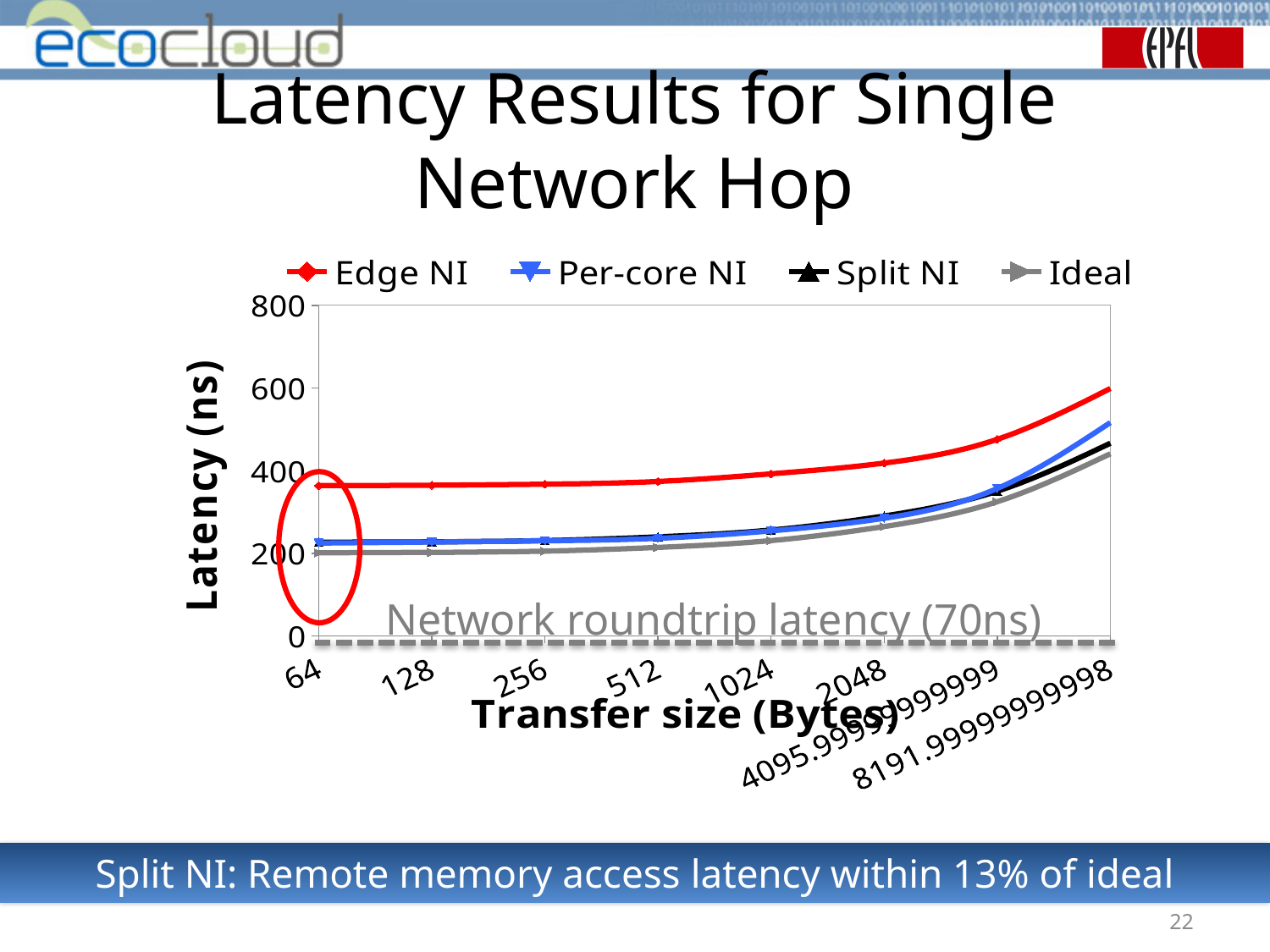
How many transfer sizes are shown along the x axis? 8 Is the Edge NI latency at 8191.99999999998 bytes greater or less than 400? greater Is the Ideal latency at 64 bytes greater or less than 400? less Which series has the lowest latency at a transfer size of 8191.99999999998 bytes? Ideal What is the title of the y axis? Latency (ns) What kind of chart is shown on the slide? line chart Which series has the highest latency at a transfer size of 64 bytes? Edge NI Is the Per-core NI latency at 8191.99999999998 bytes greater or less than 400? greater How many series does the legend list? 4 Does the Edge NI latency rise or fall as transfer size increases along the x axis? rise At a transfer size of 2048 bytes, which has the larger latency, Edge NI or Ideal? Edge NI